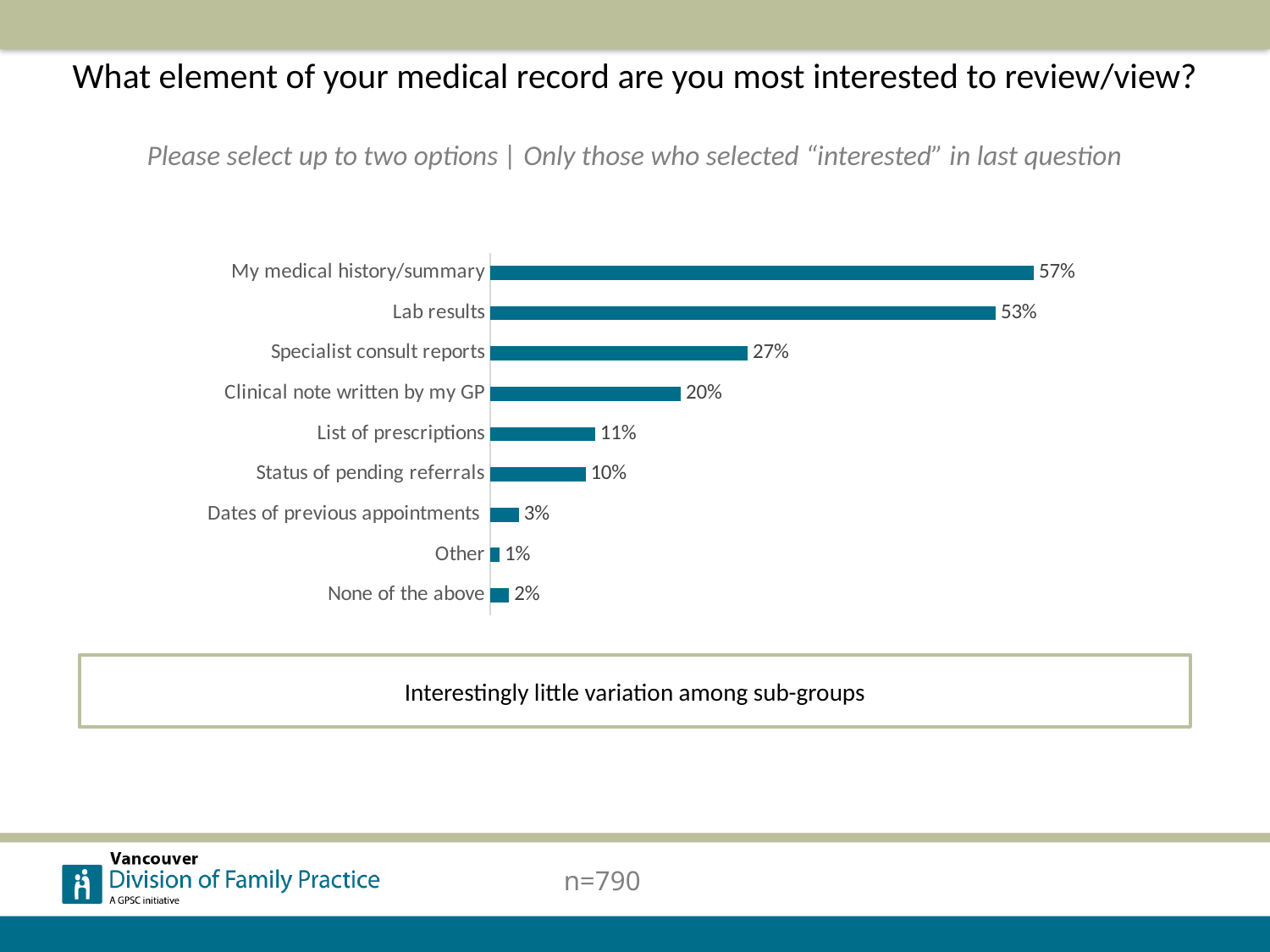
Which is larger: "List of prescriptions" or "Dates of previous appointments"? List of prescriptions Which category has the lowest percentage? Other Which element of the medical record has the highest percentage? My medical history/summary What percentage of respondents selected "Lab results"? 53% What percentage is shown for "Status of pending referrals"? 10% How many categories are shown in the chart? 9 What kind of chart is shown on the slide? Bar chart What is the value shown for "Clinical note written by my GP"? 20% What is the sample size (n) shown on the slide? n=790 Which is larger: "None of the above" or "Other"? None of the above What is the difference between "Specialist consult reports" and "Clinical note written by my GP"? 7% What is the difference between "My medical history/summary" and "Lab results"? 4%